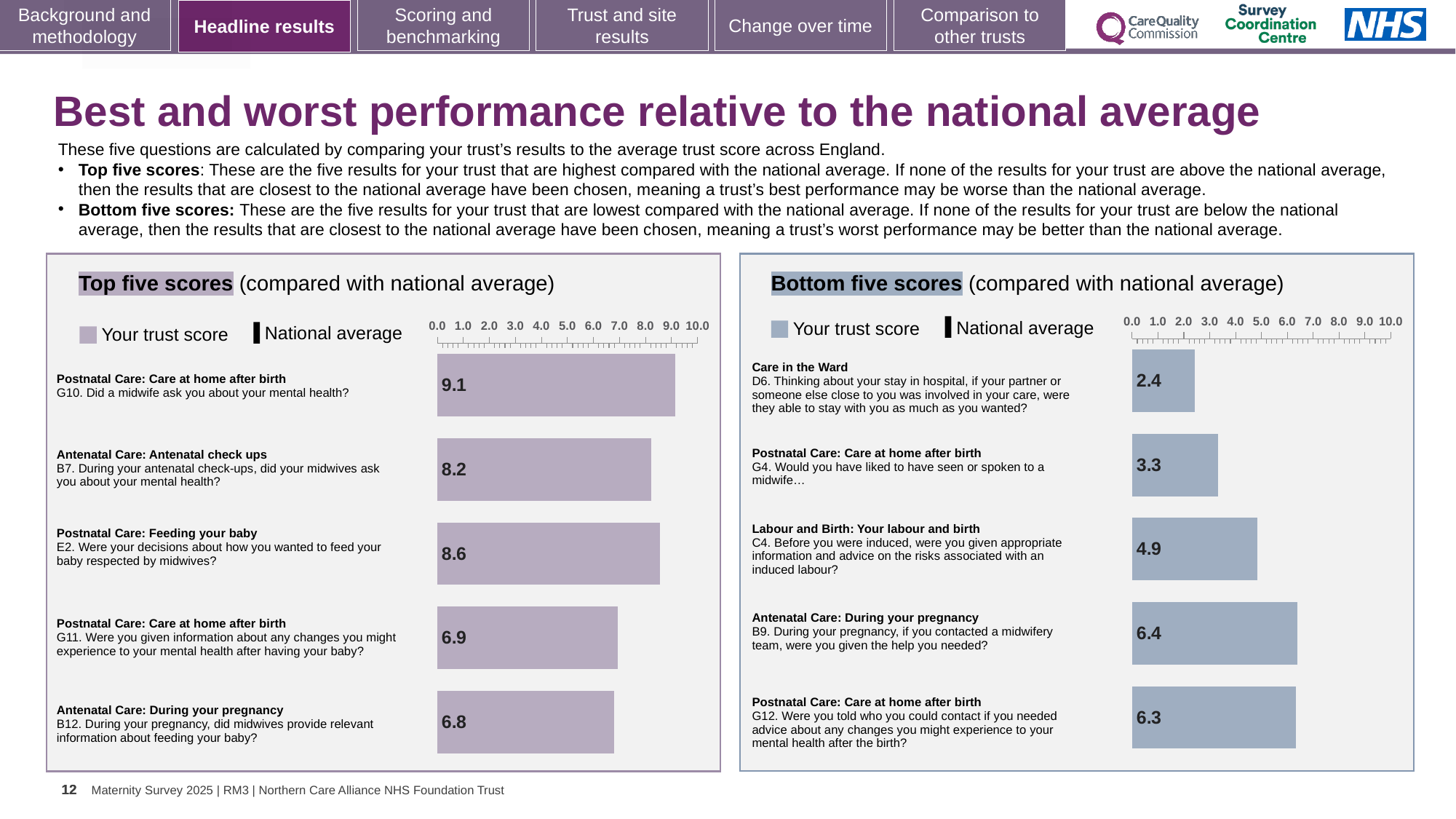
In the Top five scores chart, what is the trust score for B7 (During your antenatal check-ups, did your midwives ask you about your mental health?)? 8.2 What type of chart is used for the Top five scores? Bar chart In the Top five scores chart, what is the trust score for G10 (Did a midwife ask you about your mental health?)? 9.1 How many series does the legend of the Top five scores chart list? 2 How many bars are shown in the Bottom five scores chart? 5 In the Bottom five scores chart, which question has the lowest trust score? D6 (Care in the Ward) In the Bottom five scores chart, what is the difference between the trust scores for G4 and D6? 0.9 In the Top five scores chart, which has the larger trust score: E2 (Feeding your baby) or B7 (Antenatal check ups)? E2 (Feeding your baby) In the Bottom five scores chart, what is the trust score for B9 (Antenatal Care: During your pregnancy)? 6.4 In the Top five scores chart, which question has the highest trust score? G10. Did a midwife ask you about your mental health? In the Bottom five scores chart, what is the trust score for D6 (Care in the Ward)? 2.4 In the Top five scores chart, what is the difference between the trust scores for G10 and B12? 2.3